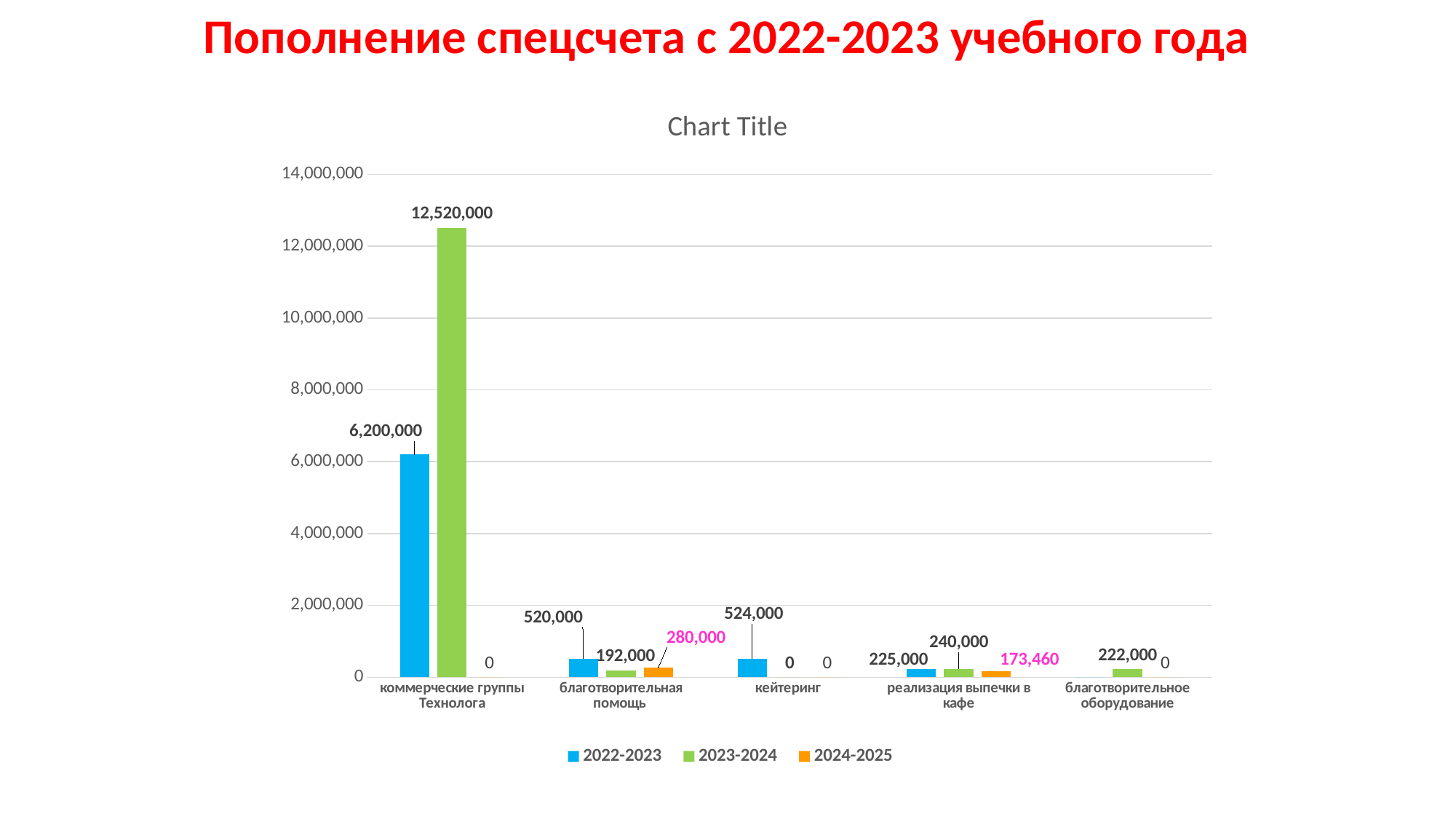
What is the difference between the 2022-2023 and 2023-2024 values for благотворительная помощь? 328,000 What is the value for 2023-2024 in the кейтеринг category? 0 What is the value for 2022-2023 in the благотворительная помощь category? 520,000 What is the value for 2024-2025 in the реализация выпечки в кафе category? 173,460 Is the 2022-2023 value for коммерческие группы Технолога greater or less than 4,000,000? greater How many categories are shown on the x axis? 5 Which category has the highest value for the 2022-2023 series? коммерческие группы Технолога What is the value for 2023-2024 in the коммерческие группы Технолога category? 12,520,000 How many series does the legend list? 3 For реализация выпечки в кафе, which series has the larger value: 2022-2023 or 2023-2024? 2023-2024 What kind of chart is shown on the slide? bar chart What is the difference between the 2023-2024 and 2022-2023 values for коммерческие группы Технолога? 6,320,000